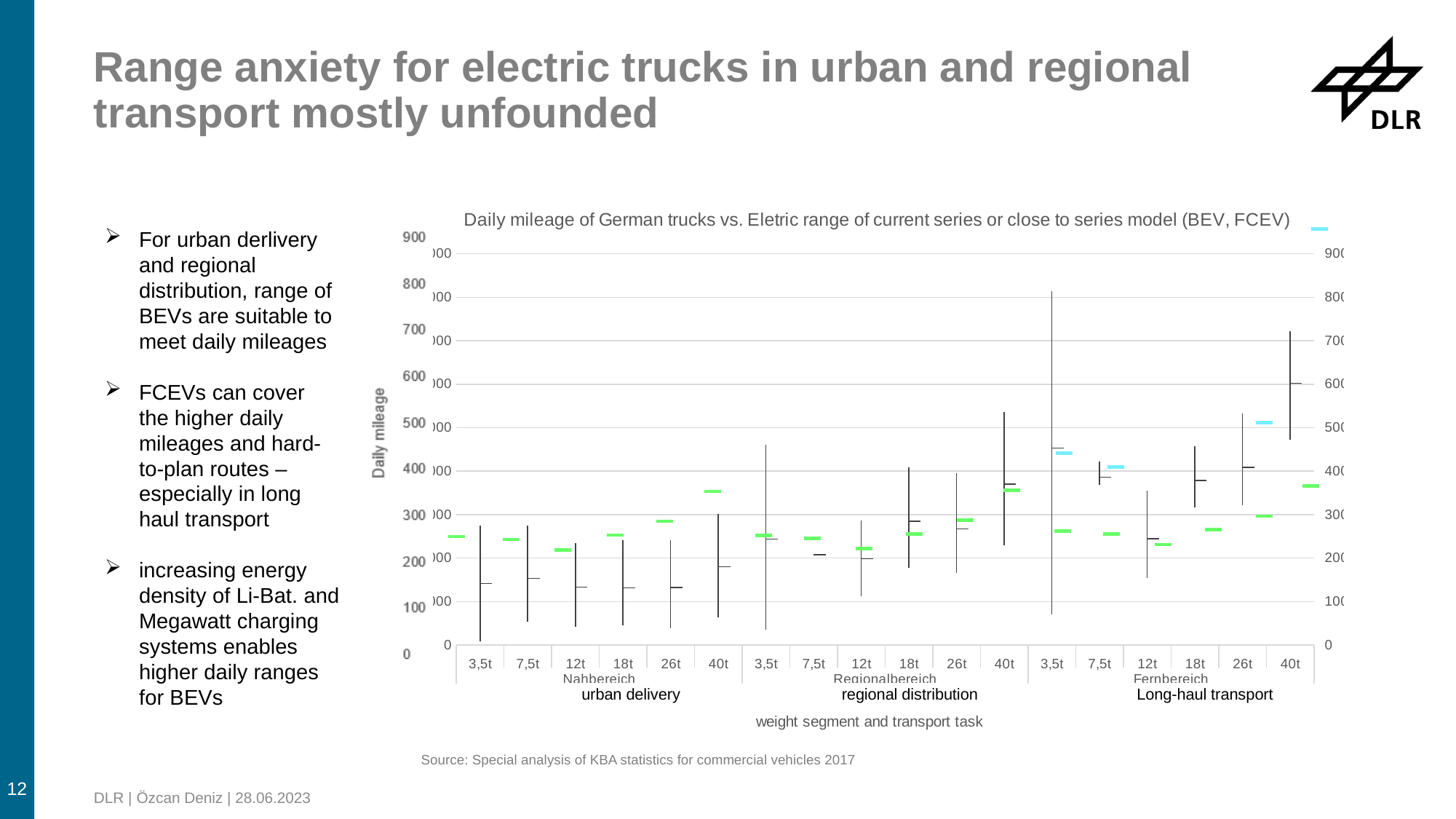
What is the title of the chart? Daily mileage of German trucks vs. Eletric range of current series or close to series model (BEV, FCEV) Which weight segment in urban delivery has the highest green marker? 40t Is the green marker for 40t in urban delivery greater or less than 300? greater Which weight segment in Long-haul transport has the highest light blue marker? 40t Is the light blue marker for 3,5t in Long-haul transport greater or less than 400? greater Is the light blue marker for 40t in Long-haul transport greater or less than 400? greater How many weight segments are shown within each transport task group on the chart? 6 What is the x-axis title of the chart? weight segment and transport task How many weight-segment categories are shown along the x axis of the chart? 18